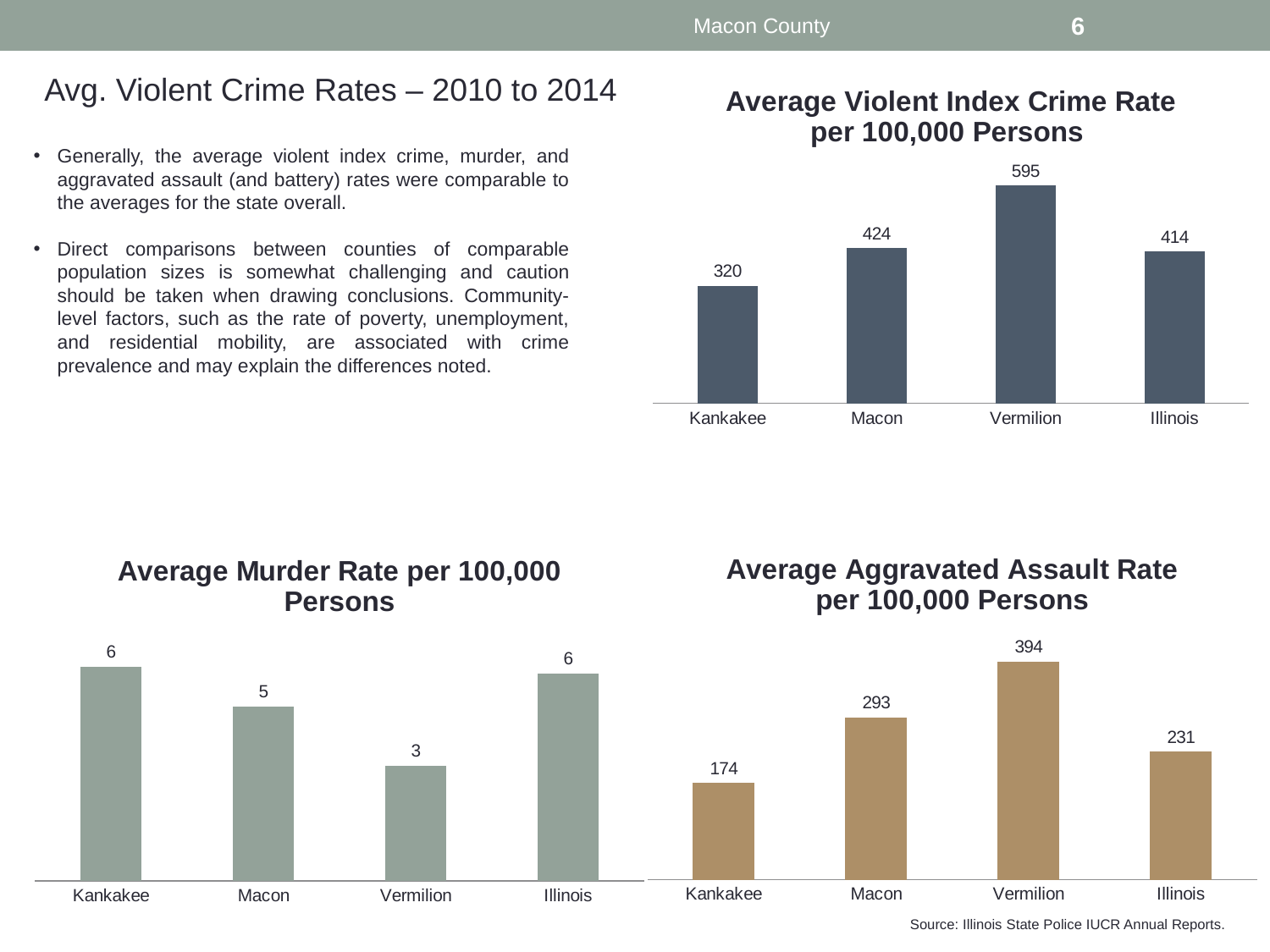
What is the title of the chart in the top right of the slide? Average Violent Index Crime Rate per 100,000 Persons In the 'Average Murder Rate per 100,000 Persons' chart, which category has the lowest value? Vermilion In the 'Average Murder Rate per 100,000 Persons' chart, what is the value for Vermilion? 3 In the 'Average Violent Index Crime Rate per 100,000 Persons' chart, which category has the highest value? Vermilion In the 'Average Aggravated Assault Rate per 100,000 Persons' chart, what is the difference between the values for Macon and Illinois? 62 In the 'Average Violent Index Crime Rate per 100,000 Persons' chart, what is the value for Macon? 424 In the 'Average Violent Index Crime Rate per 100,000 Persons' chart, what is the difference between the values for Vermilion and Kankakee? 275 In the 'Average Murder Rate per 100,000 Persons' chart, how many categories are shown? 4 In the 'Average Violent Index Crime Rate per 100,000 Persons' chart, which is larger, the value for Macon or the value for Illinois? Macon What kind of chart is the 'Average Aggravated Assault Rate per 100,000 Persons' chart? Bar chart In the 'Average Aggravated Assault Rate per 100,000 Persons' chart, which category has the highest value? Vermilion In the 'Average Aggravated Assault Rate per 100,000 Persons' chart, what is the value for Kankakee? 174